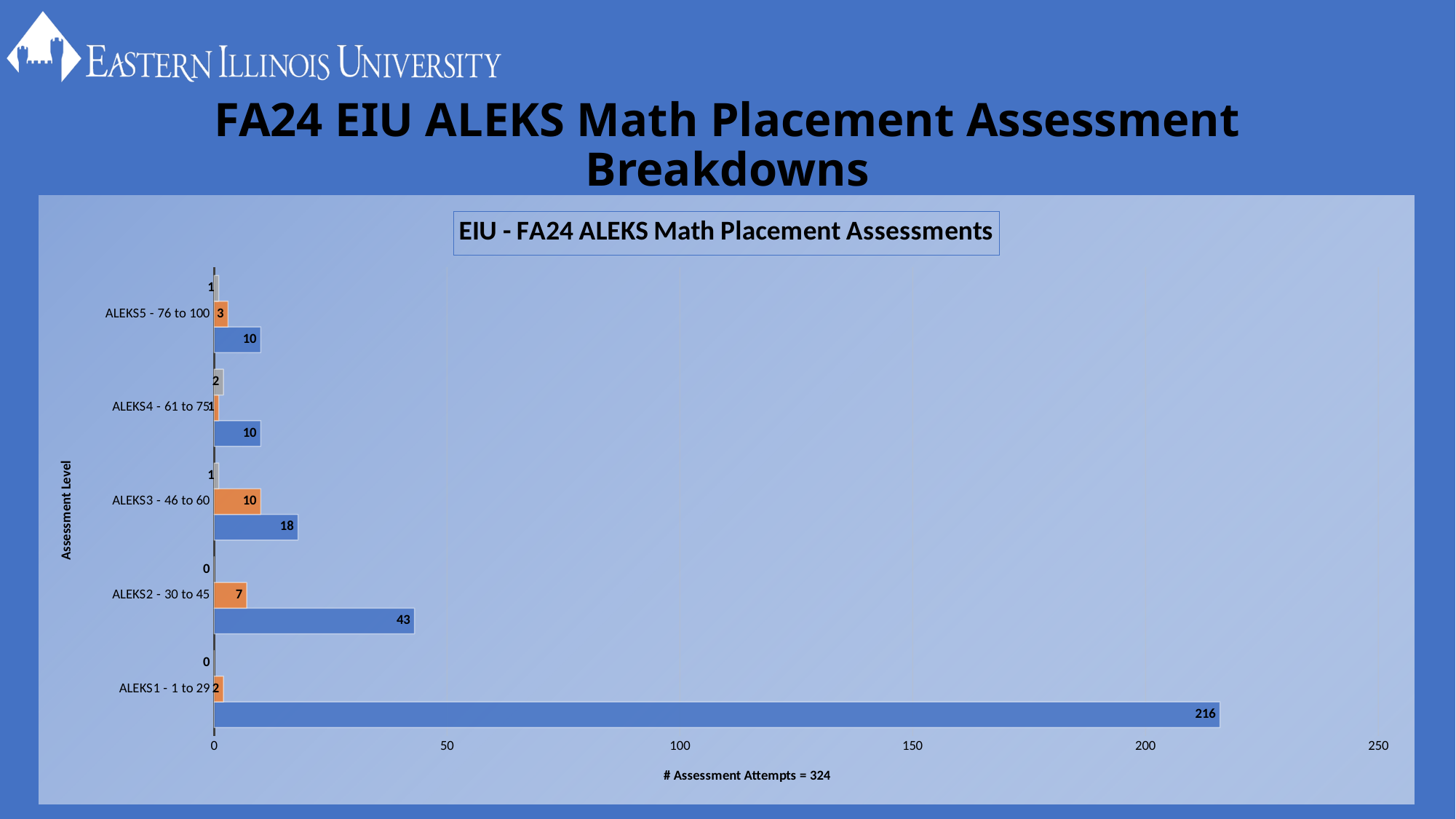
Which assessment level has the highest orange bar value? ALEKS3 - 46 to 60 What is the value of the gray bar for ALEKS4 - 61 to 75? 2 Which assessment level has the highest blue bar value? ALEKS1 - 1 to 29 Which is larger, the blue bar for ALEKS3 - 46 to 60 or the blue bar for ALEKS5 - 76 to 100? ALEKS3 - 46 to 60 What is the value of the blue bar for ALEKS1 - 1 to 29? 216 How many assessment levels are shown on the y axis? 5 What is the value of the blue bar for ALEKS2 - 30 to 45? 43 What is the value of the orange bar for ALEKS3 - 46 to 60? 10 What is the x-axis title of the chart? # Assessment Attempts = 324 What type of chart is shown on the slide? bar chart What is the difference between the blue bar values for ALEKS1 - 1 to 29 and ALEKS2 - 30 to 45? 173 What is the title of the chart? EIU - FA24 ALEKS Math Placement Assessments